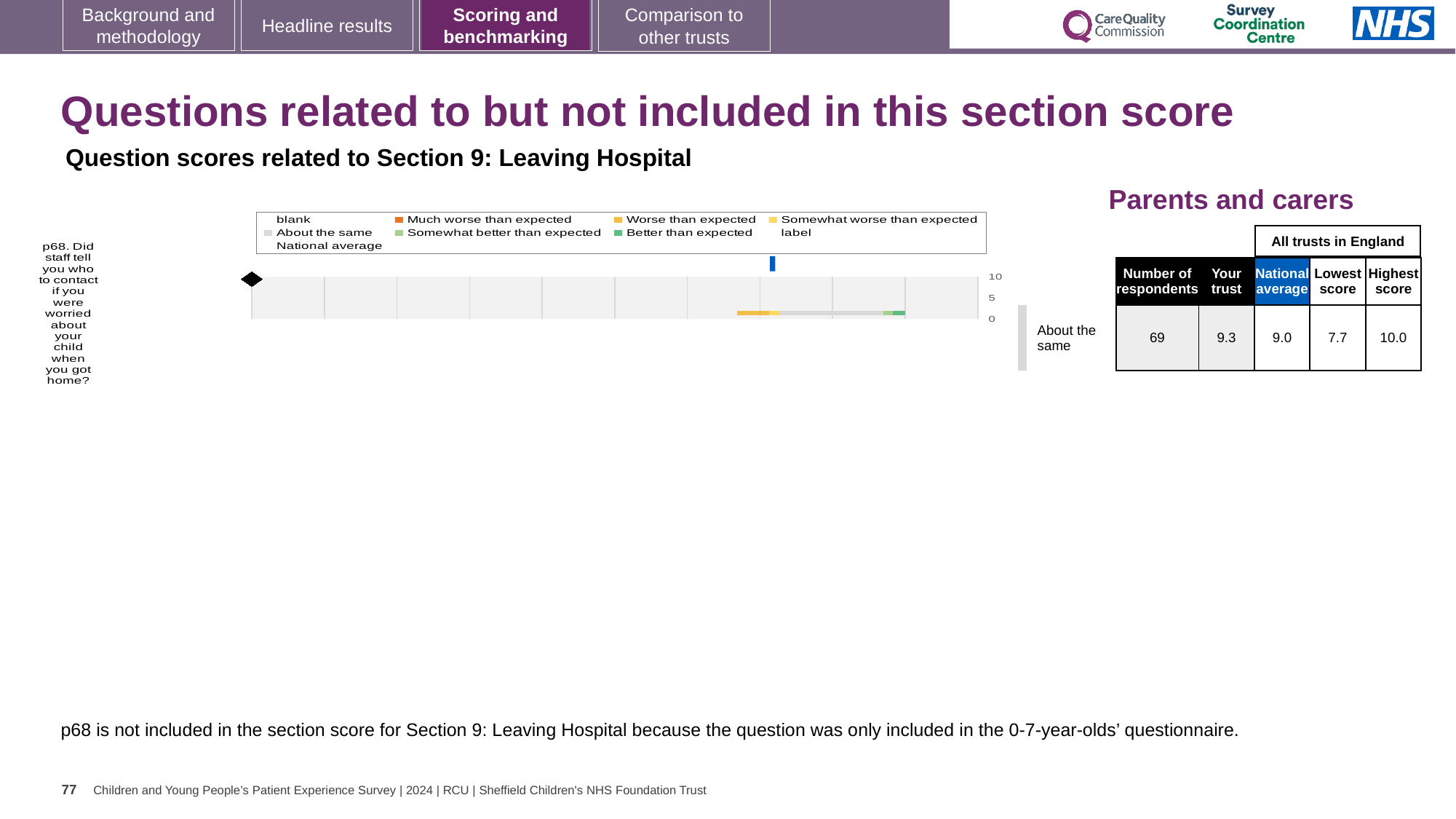
How many entries does the chart legend list? 9 Which question is plotted in the chart? p68. Did staff tell you who to contact if you were worried about your child when you got home? What kind of chart is shown on the slide? bar chart In the table next to the chart, what is the difference between the highest score and the lowest score for p68? 2.3 How many questions (categories) are plotted in the chart? 1 In the table next to the chart, how many respondents answered p68? 69 In the table next to the chart, what is the national average score for p68? 9.0 What is the highest value shown on the chart's axis? 10 In the table next to the chart, what is the difference between the 'Your trust' score and the national average for p68? 0.3 In the table next to the chart, what is the 'Your trust' score for p68? 9.3 In the table next to the chart, which is larger for p68: the 'Your trust' score or the national average? Your trust Is the national average marker for p68 greater or less than 5 on the chart axis? greater